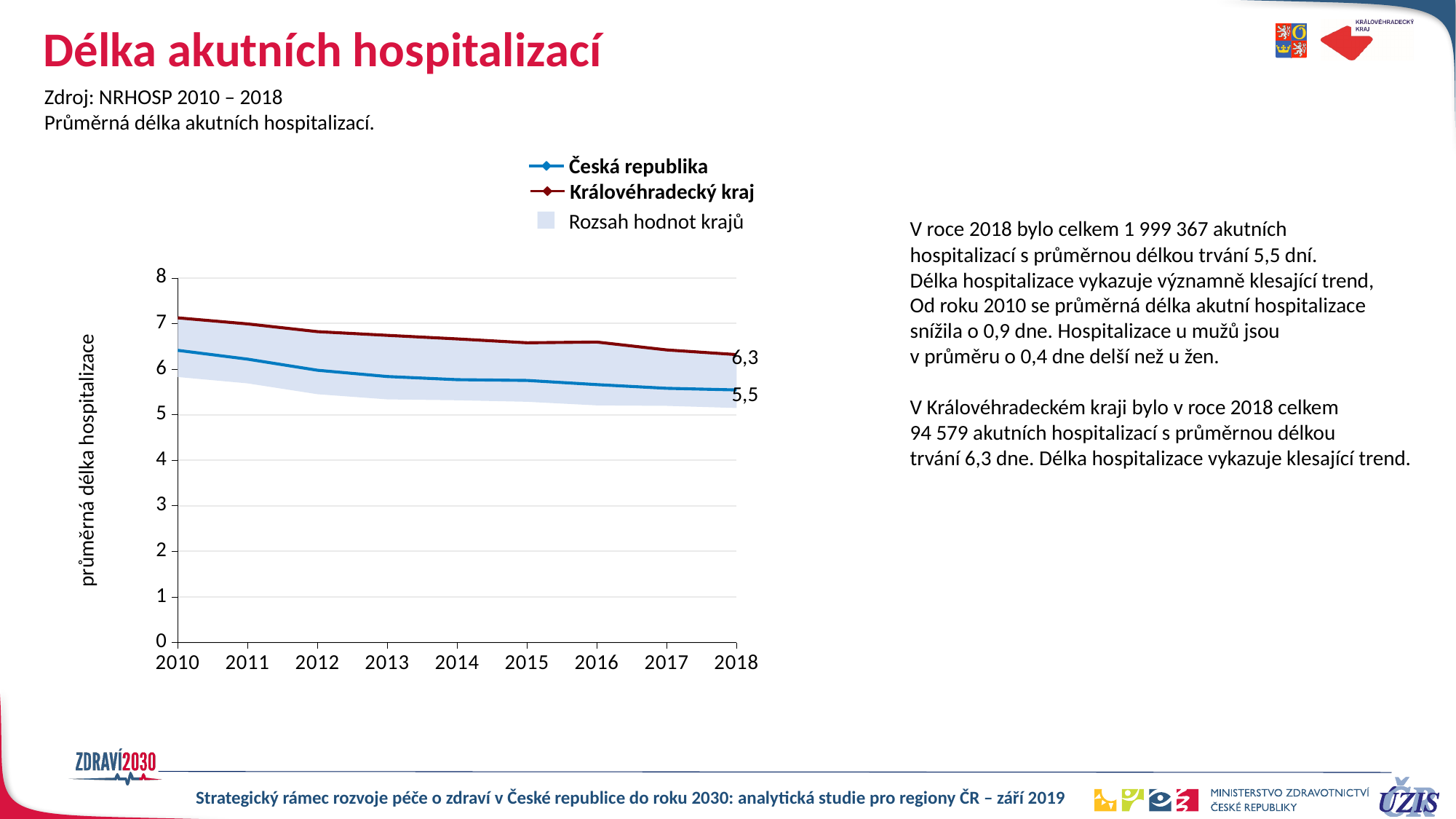
What is the value for Česká republika in 2018? 5,5 Is the value for Česká republika in 2014 greater or less than 6? less What is the label of the y axis? průměrná délka hospitalizace Does the Česká republika line rise or fall from 2010 to 2018? fall What is the value for Královéhradecký kraj in 2018? 6,3 In 2018, which series has the higher value: Česká republika or Královéhradecký kraj? Královéhradecký kraj What kind of chart is shown on the slide? line chart How many years are shown on the x axis? 9 How many entries does the legend list? 3 Is the value for Česká republika in 2010 greater or less than 6? greater Is the value for Královéhradecký kraj in 2010 greater or less than 7? greater What is the difference between the 2018 values for Královéhradecký kraj and Česká republika? 0,8